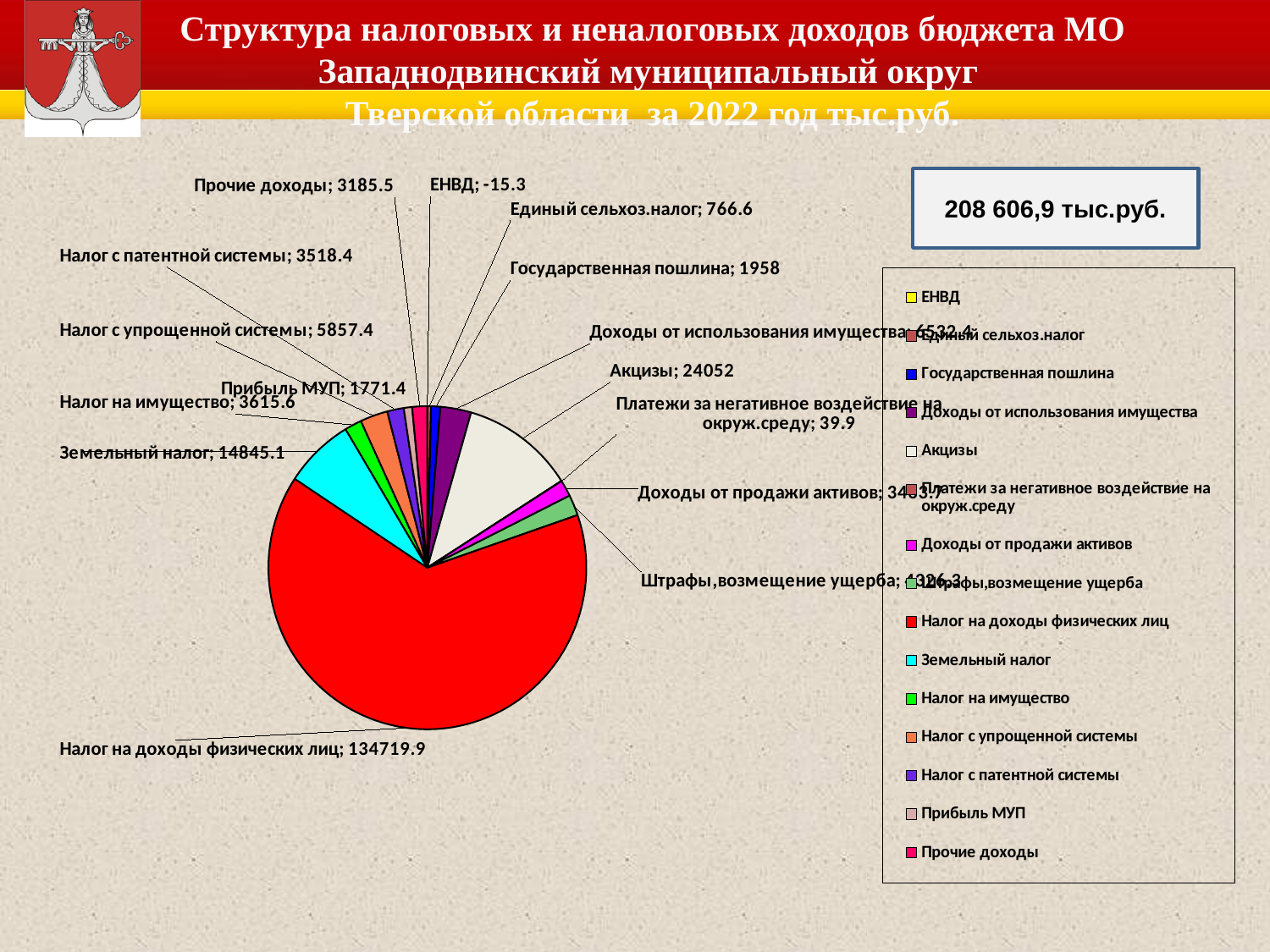
What is the value for Налог на доходы физических лиц in the pie chart? 134719.9 Which category has the smallest value in the pie chart? ЕНВД Which category has the largest value in the pie chart? Налог на доходы физических лиц What is the value for ЕНВД in the pie chart? -15.3 Which is larger, Налог с упрощенной системы or Налог с патентной системы? Налог с упрощенной системы What kind of chart is shown on the slide? Pie chart What is the difference between Акцизы and Земельный налог? 9206.9 How many categories does the legend of the pie chart list? 15 What is the value for Земельный налог in the pie chart? 14845.1 What is the value for Государственная пошлина in the pie chart? 1958 What is the difference between Земельный налог and Налог на имущество? 11229.5 What is the value for Акцизы in the pie chart? 24052